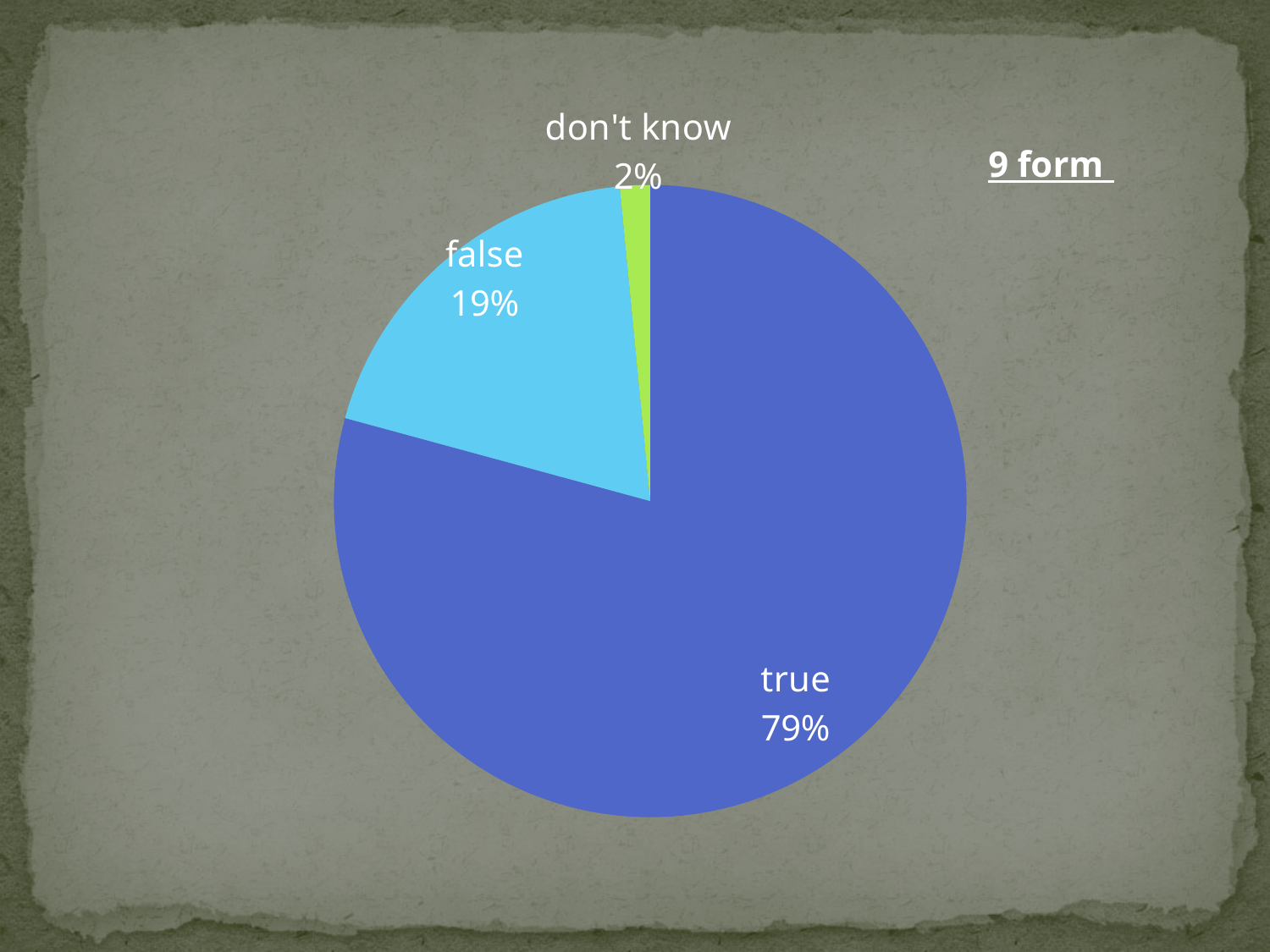
What colour is the "true" slice of the pie? blue Which slice of the pie is the largest? true What text appears in the top right corner of the slide above the chart? 9 form How many slices does the pie chart have? 3 What kind of chart is shown on the slide? pie chart Which is larger, the "false" slice or the "don't know" slice? false What is the difference in percentage points between the "false" and "don't know" slices? 17 What is the difference in percentage points between the "true" and "false" slices? 60 What percentage of the pie is labelled "false"? 19% Which slice of the pie is the smallest? don't know What percentage of the pie is labelled "don't know"? 2% What percentage of the pie is labelled "true"? 79%